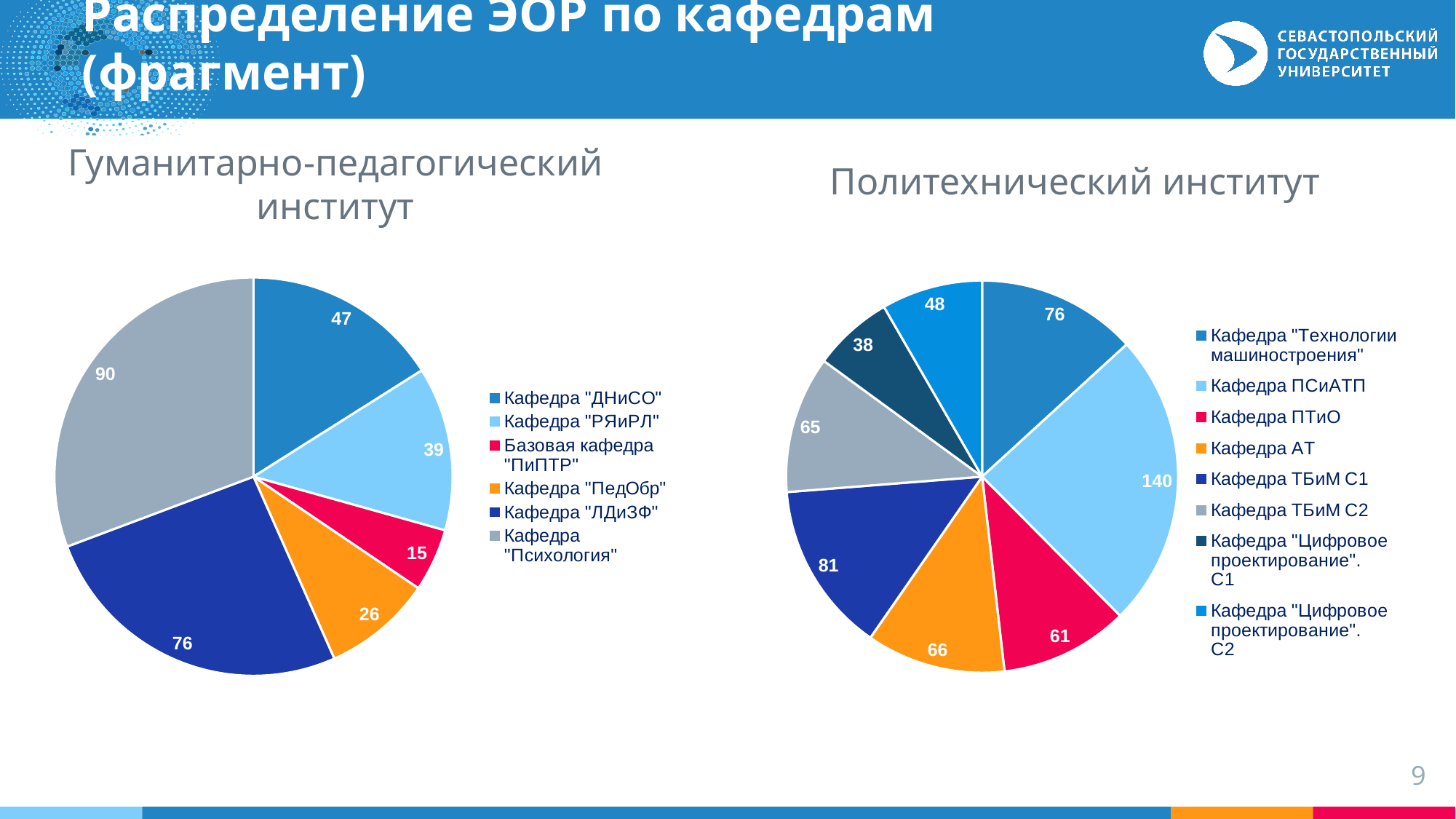
In the chart titled "Политехнический институт", how many categories does the legend list? 8 In the chart titled "Политехнический институт", which category has the smallest value? Кафедра "Цифровое проектирование". С1 In the chart titled "Гуманитарно-педагогический институт", which category has the largest value? Кафедра "Психология" In the chart titled "Политехнический институт", what is the value for Кафедра ТБиМ С1? 81 In the chart titled "Политехнический институт", what is the value for Кафедра ПСиАТП? 140 In the chart titled "Гуманитарно-педагогический институт", what is the value for Кафедра "ДНиСО"? 47 In the chart titled "Политехнический институт", which is larger: Кафедра АТ or Кафедра ПТиО? Кафедра АТ In the chart titled "Гуманитарно-педагогический институт", what is the difference between the values for Кафедра "ЛДиЗФ" and Кафедра "ПедОбр"? 50 In the chart titled "Гуманитарно-педагогический институт", how many categories are shown? 6 In the chart titled "Политехнический институт", what is the difference between the values for Кафедра ПСиАТП and Кафедра "Технологии машиностроения"? 64 What kind of chart is the one titled "Политехнический институт"? Pie chart In the chart titled "Гуманитарно-педагогический институт", which category has the smallest value? Базовая кафедра "ПиПТР"